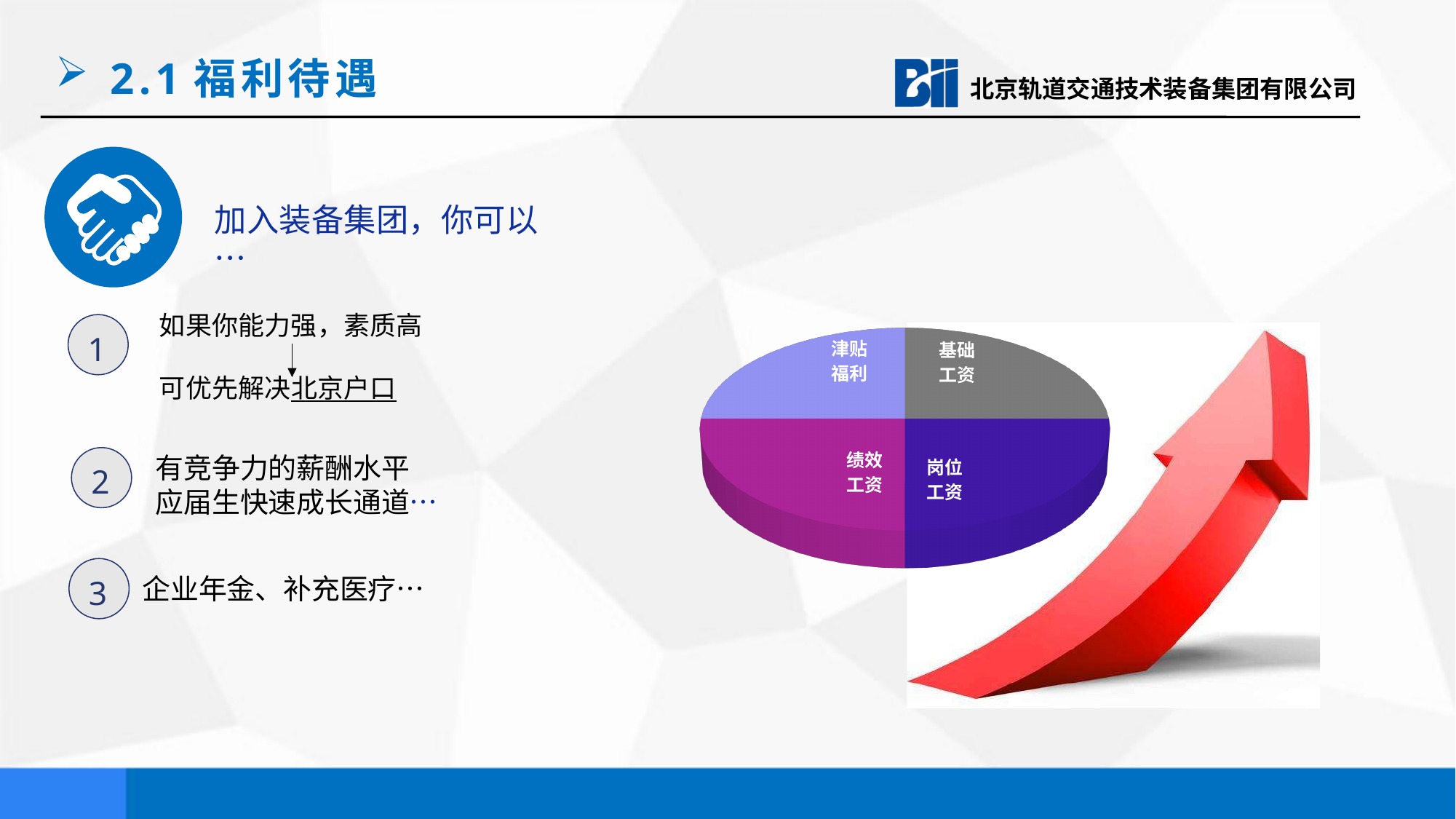
What colour is the 绩效工资 slice of the pie chart? Magenta (purple-red) How many slices does the pie chart have? 4 Which slice of the pie chart is coloured gray? 基础工资 Which slice of the pie chart is located in the lower-right quarter? 岗位工资 Which slice of the pie chart is located in the upper-left quarter? 津贴福利 What kind of chart is shown on the right side of the slide? Pie chart